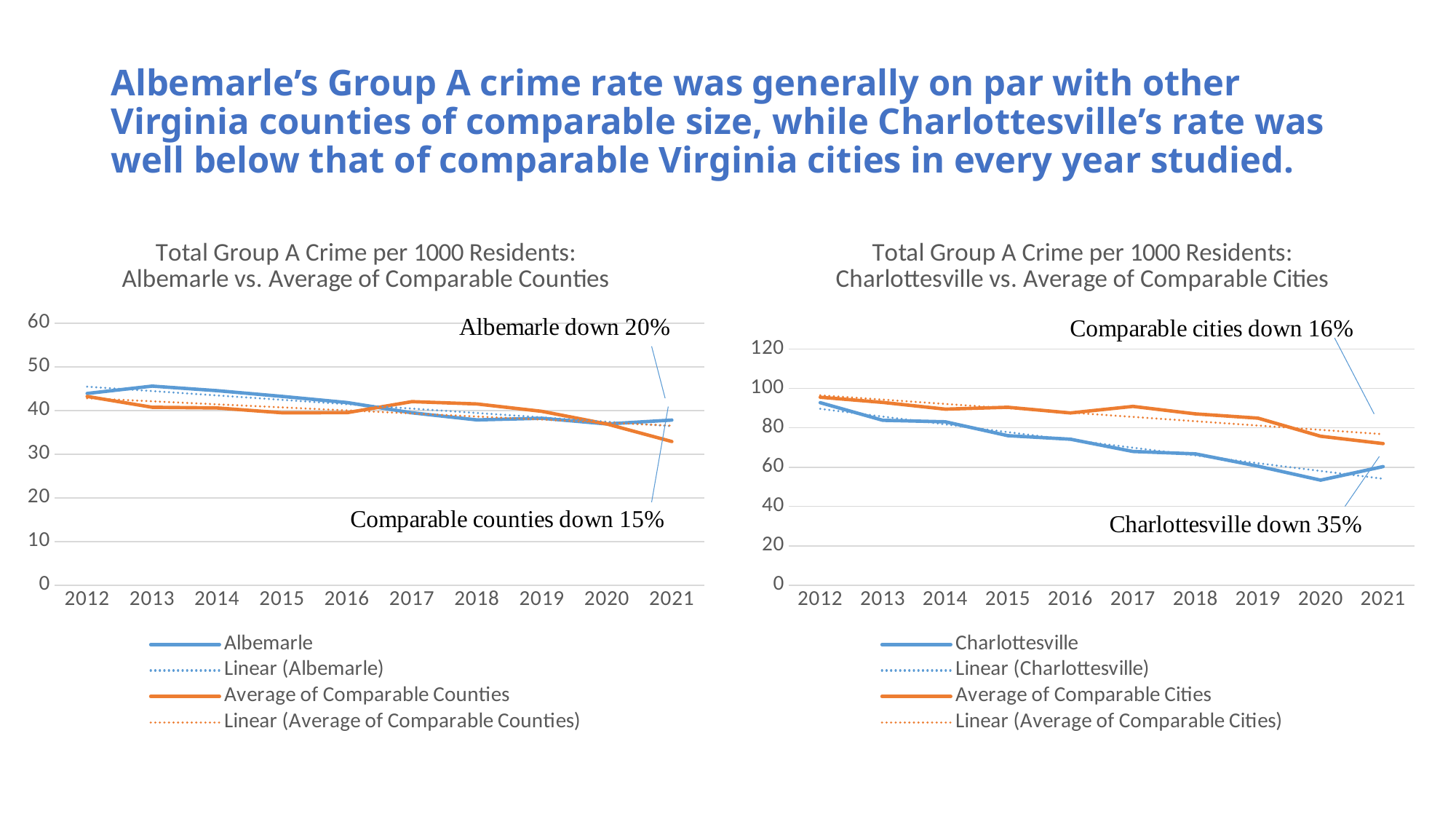
In the right chart (Charlottesville vs. Average of Comparable Cities), is the Average of Comparable Cities value for 2017 greater or less than 80? greater In the left chart (Albemarle vs. Average of Comparable Counties), which is larger in 2021: Albemarle or Average of Comparable Counties? Albemarle In the left chart (Albemarle vs. Average of Comparable Counties), does the Albemarle line generally rise or fall from 2012 to 2021? Fall In the right chart (Charlottesville vs. Average of Comparable Cities), is the Charlottesville value for 2020 greater or less than 60? less In the left chart (Albemarle vs. Average of Comparable Counties), is the Average of Comparable Counties value for 2021 greater or less than 40? less What kind of chart is the left chart, 'Total Group A Crime per 1000 Residents: Albemarle vs. Average of Comparable Counties'? Line chart In the right chart (Charlottesville vs. Average of Comparable Cities), which is larger in 2020: Charlottesville or Average of Comparable Cities? Average of Comparable Cities In the left chart (Albemarle vs. Average of Comparable Counties), how many years are shown on the x axis? 10 In the right chart (Charlottesville vs. Average of Comparable Cities), does the Charlottesville line generally rise or fall from 2012 to 2021? Fall According to the annotation on the right chart, by what percentage was Charlottesville down? 35% In the right chart (Charlottesville vs. Average of Comparable Cities), how many entries does the legend list? 4